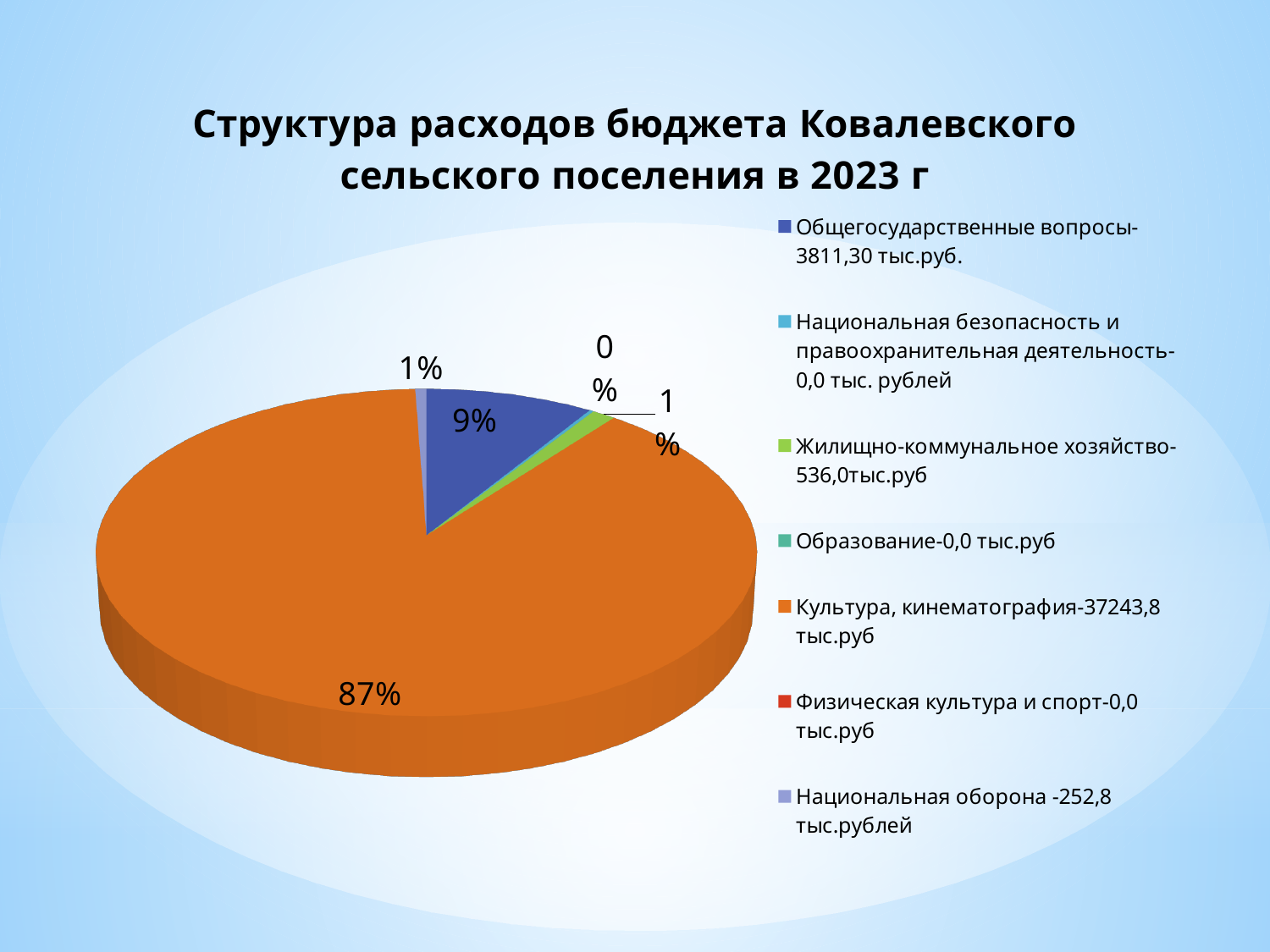
What colour is the slice for Культура, кинематография? Orange How many categories does the legend of the pie chart list? 7 According to the legend, what is the amount for Жилищно-коммунальное хозяйство? 536,0 тыс.руб What is the title of the chart? Структура расходов бюджета Ковалевского сельского поселения в 2023 г Which slice is larger: Общегосударственные вопросы or Жилищно-коммунальное хозяйство? Общегосударственные вопросы According to the legend, what is the amount for Национальная оборона? 252,8 тыс.рублей What kind of chart is shown on the slide? Pie chart What share of the pie does the slice for Культура, кинематография represent? 87% According to the legend, what is the amount for Общегосударственные вопросы? 3811,30 тыс.руб. What is the difference in percentage points between the share for Культура, кинематография and the share for Общегосударственные вопросы? 78 percentage points What share of the pie does the slice for Общегосударственные вопросы represent? 9% Which category has the largest slice of the pie? Культура, кинематография